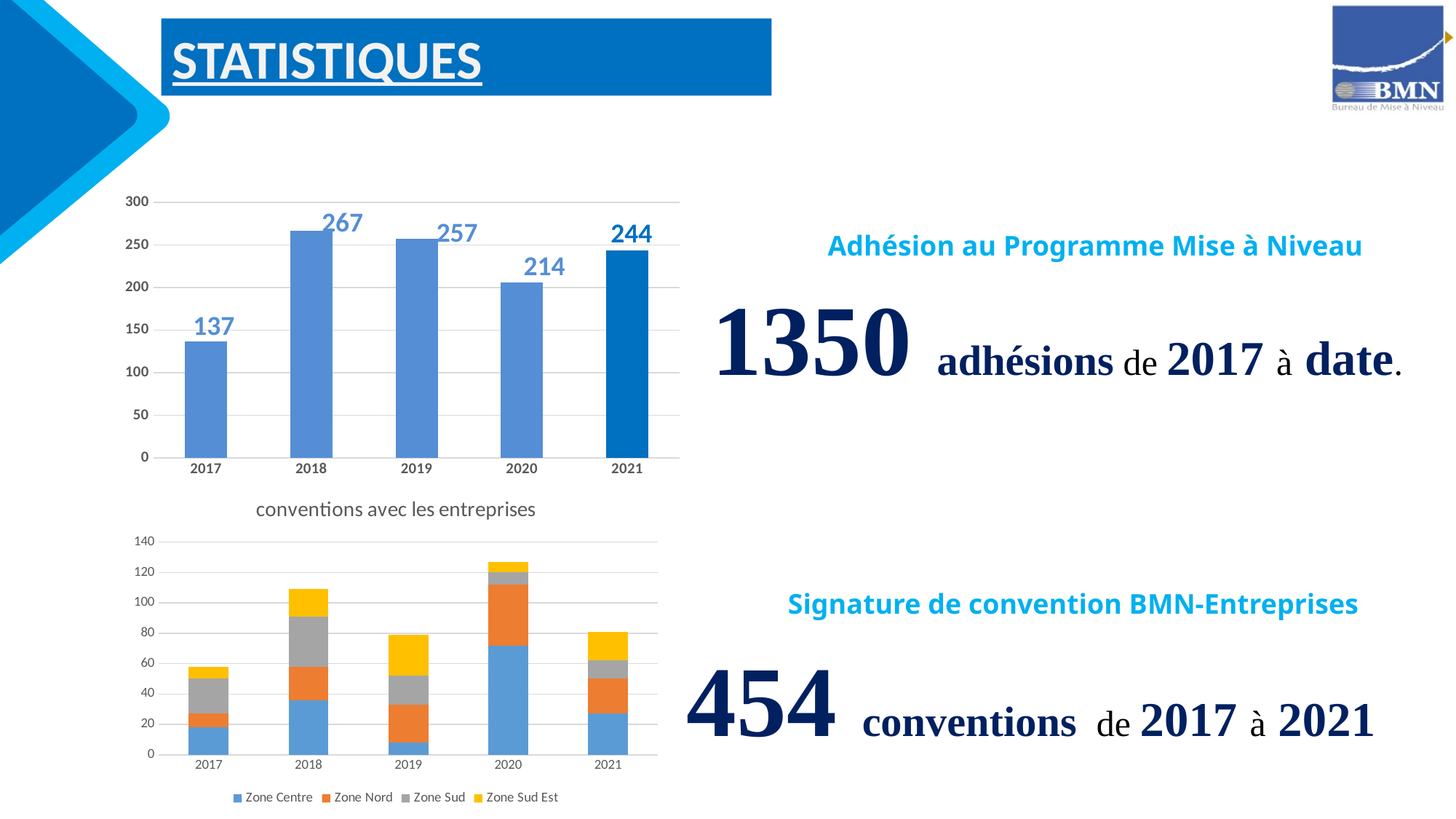
In the top chart, what is the value for 2021? 244 In the top chart, what is the difference between the values for 2018 and 2020? 53 In the chart titled 'conventions avec les entreprises', is the total stacked value for 2020 greater or less than 120? greater What kind of chart is the chart titled 'conventions avec les entreprises'? Stacked bar chart In the top chart, how many years are shown on the x axis? 5 In the chart titled 'conventions avec les entreprises', how many series does the legend list? 4 In the top chart, which year has the highest value? 2018 In the top chart, what is the value for 2017? 137 In the top chart, which year has the lowest value? 2017 In the chart titled 'conventions avec les entreprises', is the total stacked value for 2018 greater or less than 100? greater In the top chart, which is larger, the value for 2019 or the value for 2021? 2019 In the top chart, what is the value for 2018? 267